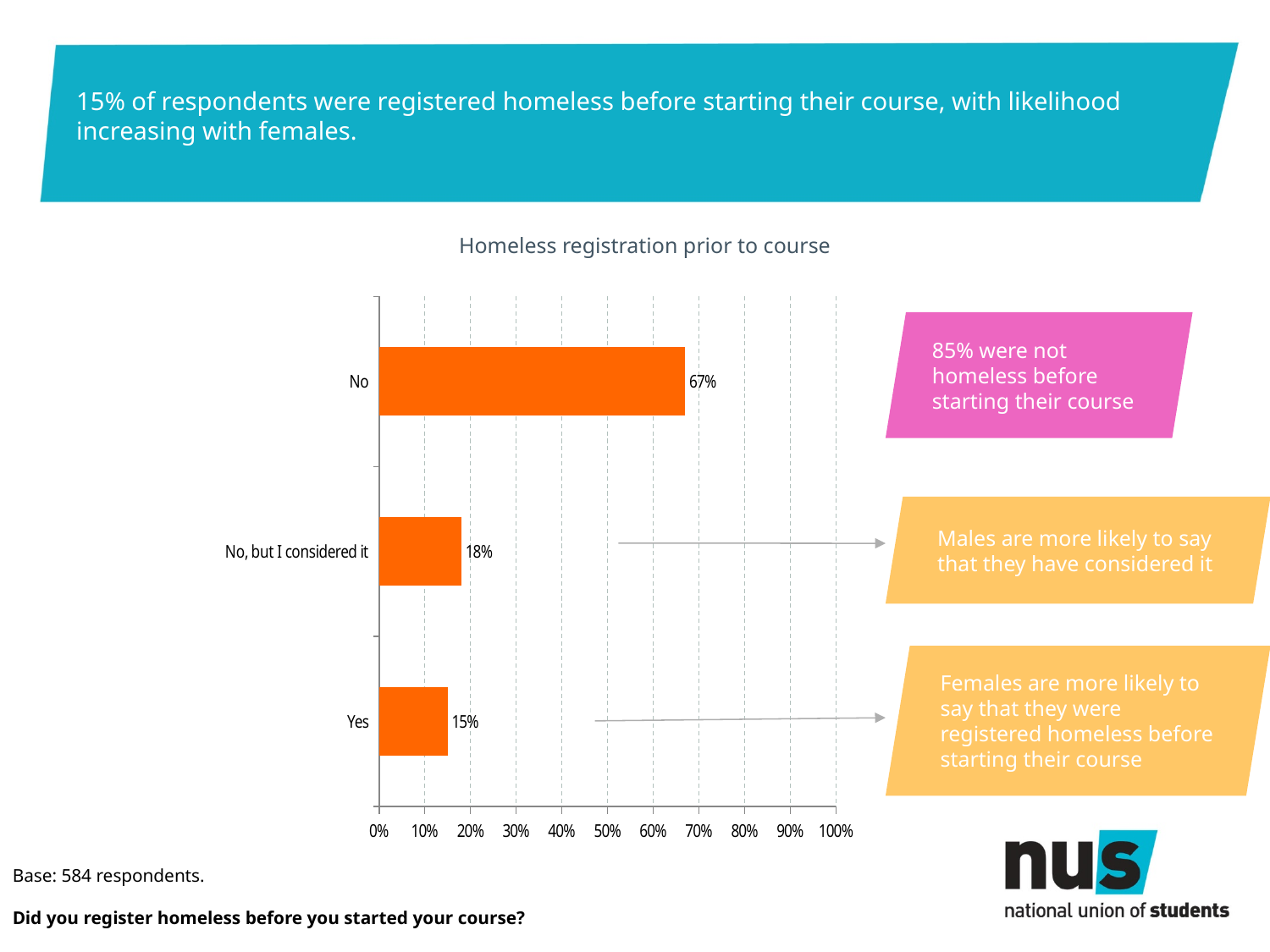
Is the value for "No" greater or less than 60%? greater What is the value for "No, but I considered it"? 18% Which category has the highest value? No What is the difference between the values for "No" and "Yes"? 52% How many categories are shown in the chart? 3 What kind of chart is shown on the slide? Bar chart What is the difference between the values for "No, but I considered it" and "Yes"? 3% What is the title of the chart? Homeless registration prior to course What is the value for "No" in the Homeless registration prior to course chart? 67% What is the value for "Yes"? 15% Which is larger, the value for "No, but I considered it" or the value for "Yes"? No, but I considered it Which category has the lowest value? Yes